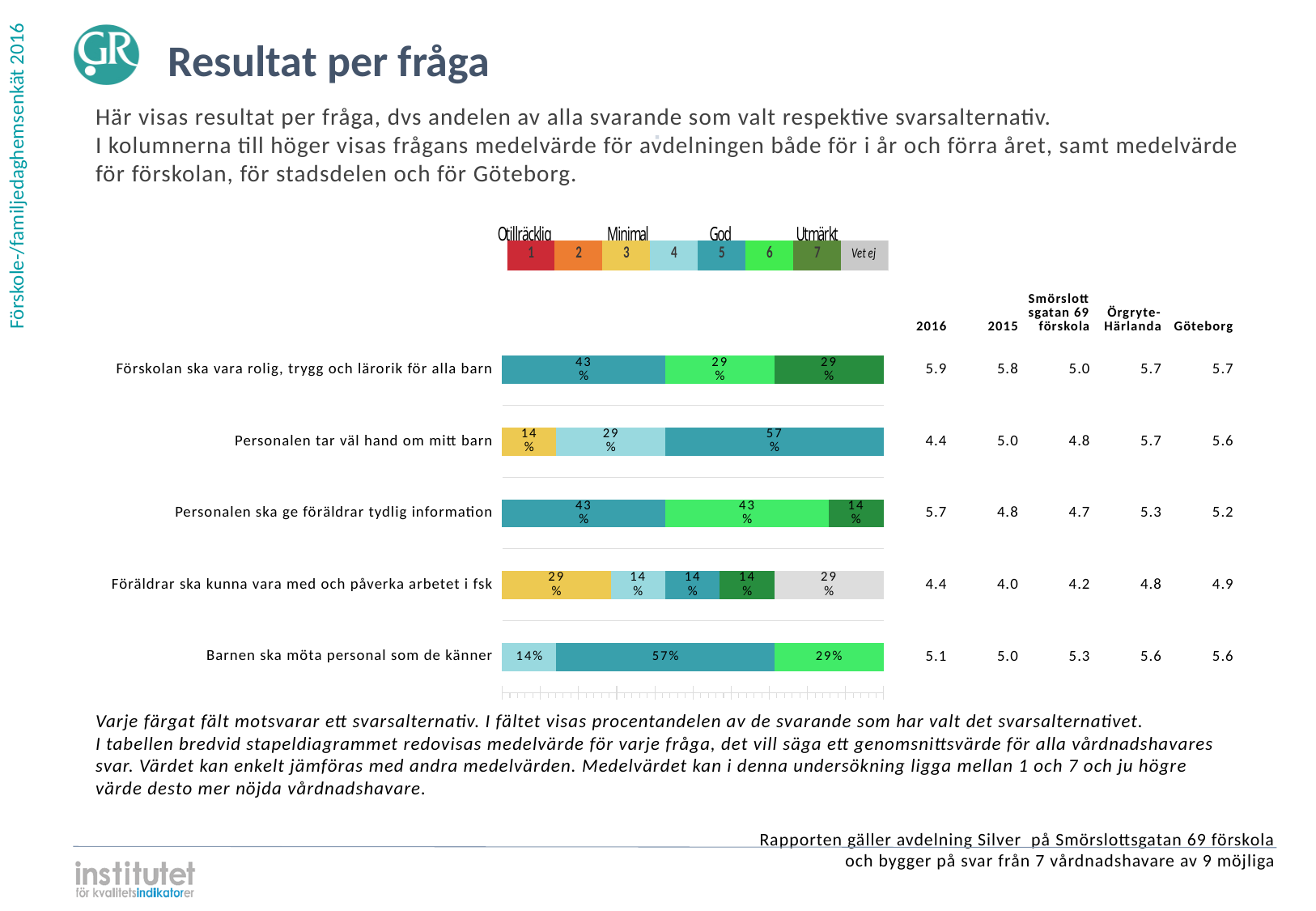
What is the total of the segments in the bar for "Barnen ska möta personal som de känner"? 100% Which answer option has the largest share for "Barnen ska möta personal som de känner"? 5 What percentage of respondents chose answer option 5 (teal) for "Personalen tar väl hand om mitt barn"? 57% What kind of chart is used to show the results per question? Stacked bar chart How many answer options does the legend above the chart list? 8 How many questions (bars) are shown in the chart? 5 What percentage chose answer option 6 (light green) for "Barnen ska möta personal som de känner"? 29% For "Förskolan ska vara rolig, trygg och lärorik för alla barn", which is larger: the share for option 5 or the share for option 6? Option 5 What share of respondents answered "Vet ej" for "Föräldrar ska kunna vara med och påverka arbetet i fsk"? 29% What is the difference between the share for option 5 and the share for option 3 in the bar for "Personalen tar väl hand om mitt barn"? 43% Which answer option has the smallest share for "Personalen ska ge föräldrar tydlig information"? 7 What percentage of respondents chose answer option 7 (dark green) for "Förskolan ska vara rolig, trygg och lärorik för alla barn"? 29%